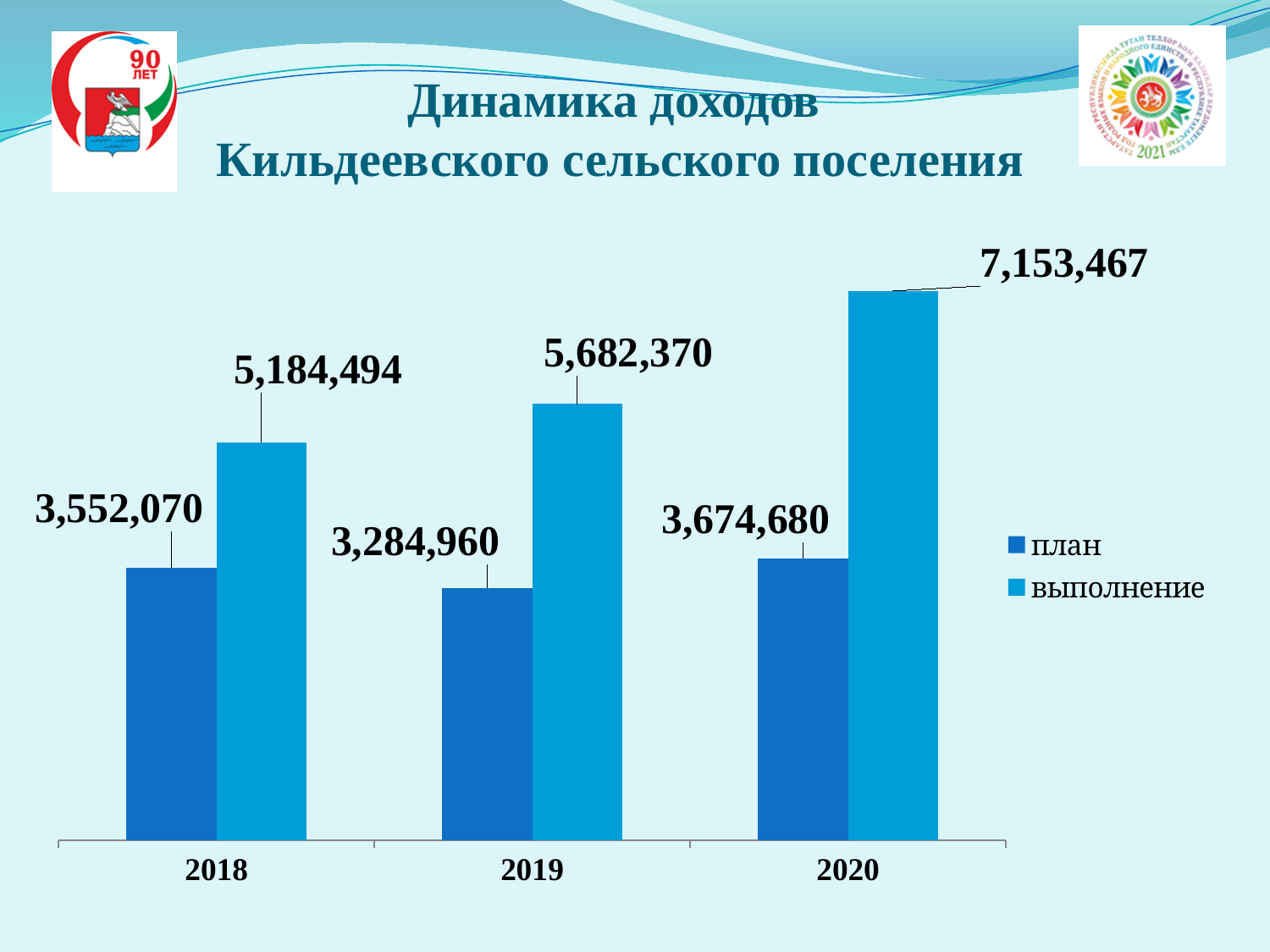
What is the value of выполнение for 2019? 5,682,370 Does the выполнение value rise or fall from 2018 to 2020? rise In which year is the план value lowest? 2019 In which year is the выполнение value highest? 2020 How many years are shown on the x axis? 3 Which is larger: план for 2020 or план for 2018? план for 2020 What is the difference between выполнение and план in 2018? 1,632,424 How many series does the legend list? 2 What is the value of план for 2018? 3,552,070 What is the difference between выполнение and план in 2020? 3,478,787 What is the value of выполнение for 2020? 7,153,467 What is the value of план for 2019? 3,284,960